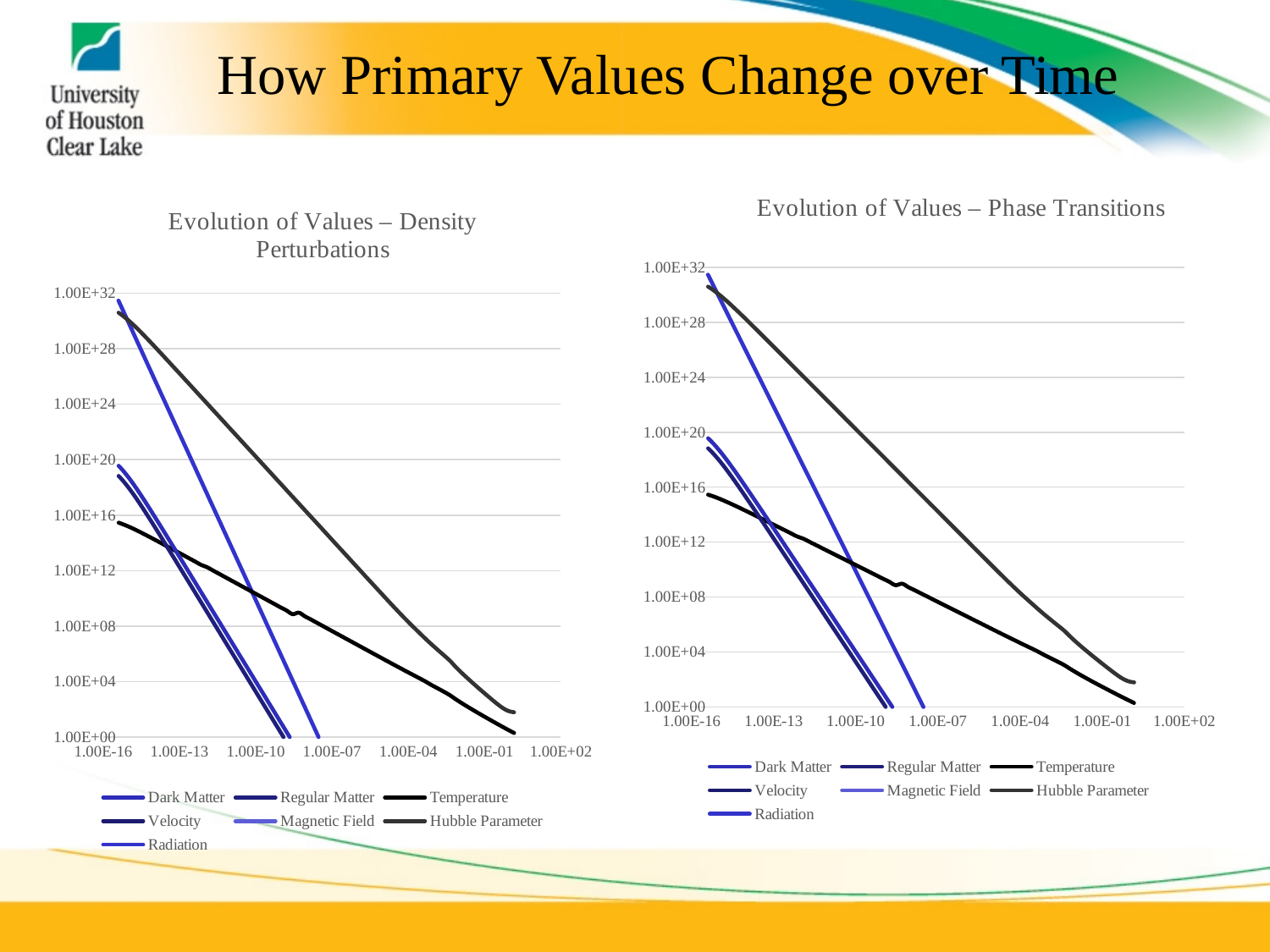
What is the title of the chart on the right side of the slide? Evolution of Values – Phase Transitions In the 'Evolution of Values – Phase Transitions' chart, is the Temperature value at x = 1.00E-16 greater or less than 1.00E+20? less What is the highest tick label shown on the y axis of the 'Evolution of Values – Density Perturbations' chart? 1.00E+32 How many series does the legend of the 'Evolution of Values – Phase Transitions' chart list? 7 In the 'Evolution of Values – Phase Transitions' chart, which series has the lowest value at x = 1.00E-16? Temperature In the 'Evolution of Values – Density Perturbations' chart, which is larger at x = 1.00E-16: the Hubble Parameter value or the Temperature value? Hubble Parameter What kind of chart is the 'Evolution of Values – Phase Transitions' chart? line chart In the 'Evolution of Values – Phase Transitions' chart, does the Temperature line rise or fall as the x axis increases? fall In the 'Evolution of Values – Density Perturbations' chart, is the Hubble Parameter value at x = 1.00E-16 greater or less than 1.00E+28? greater In the 'Evolution of Values – Density Perturbations' chart, does the Hubble Parameter line rise or fall as the x axis increases? fall How many series does the legend of the 'Evolution of Values – Density Perturbations' chart list? 7 What kind of chart is the 'Evolution of Values – Density Perturbations' chart? line chart